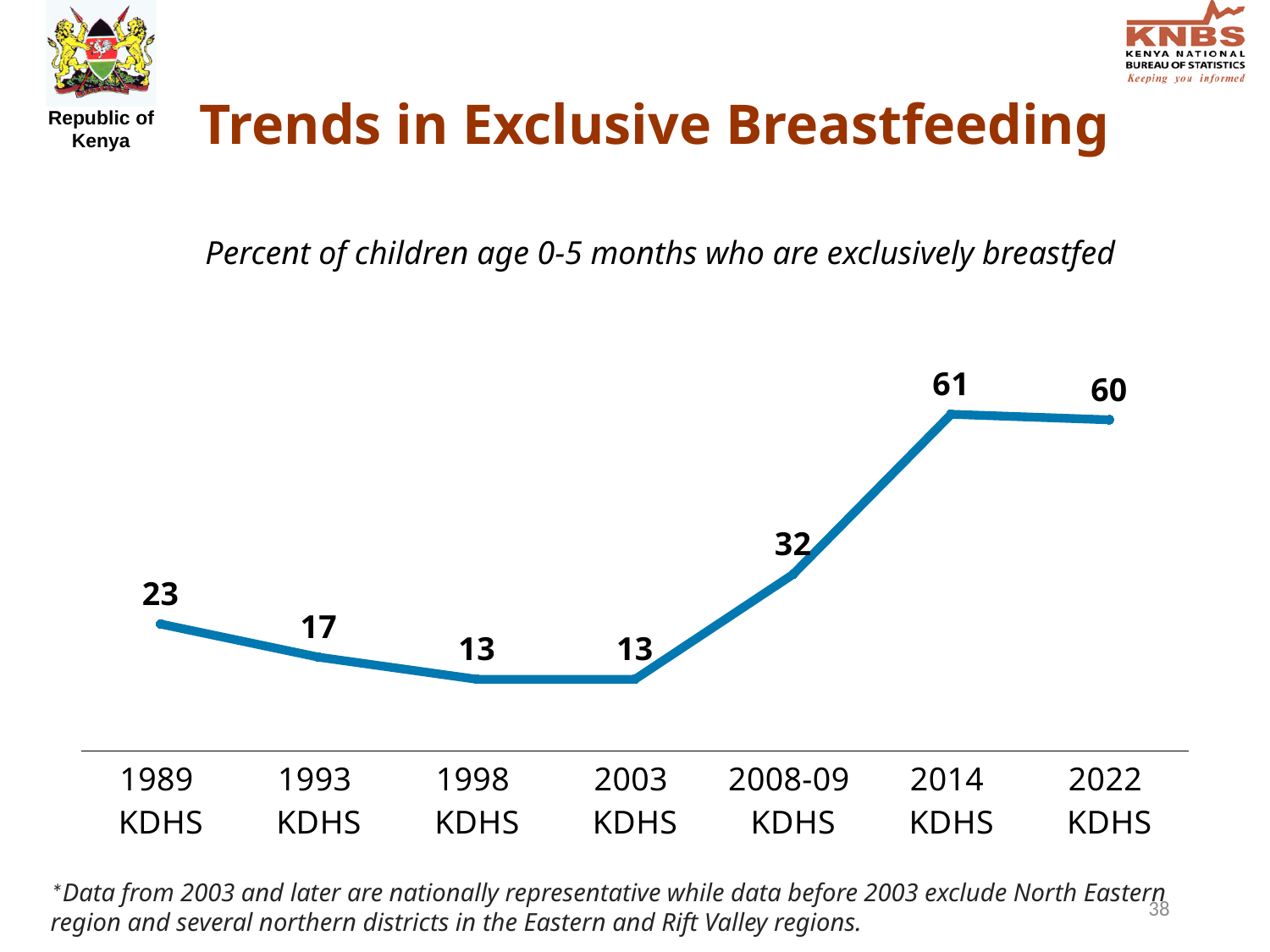
Which survey shows the highest percent of children exclusively breastfed? 2014 KDHS What is the difference between the 2014 KDHS value and the 2003 KDHS value? 48 How many survey points are plotted on the chart? 7 What kind of chart is shown on the slide? Line chart What percent of children age 0-5 months were exclusively breastfed in the 2022 KDHS? 60 What value is shown for the 1989 KDHS? 23 Does the value rise or fall between the 2003 KDHS and the 2014 KDHS? Rise Which is larger, the value for 1993 KDHS or the value for 2008-09 KDHS? 2008-09 KDHS What is the title of the chart on the slide? Trends in Exclusive Breastfeeding What is the lowest value plotted on the chart? 13 By how much did the value change from 1989 KDHS to 1993 KDHS? 6 What value is shown for the 2008-09 KDHS? 32